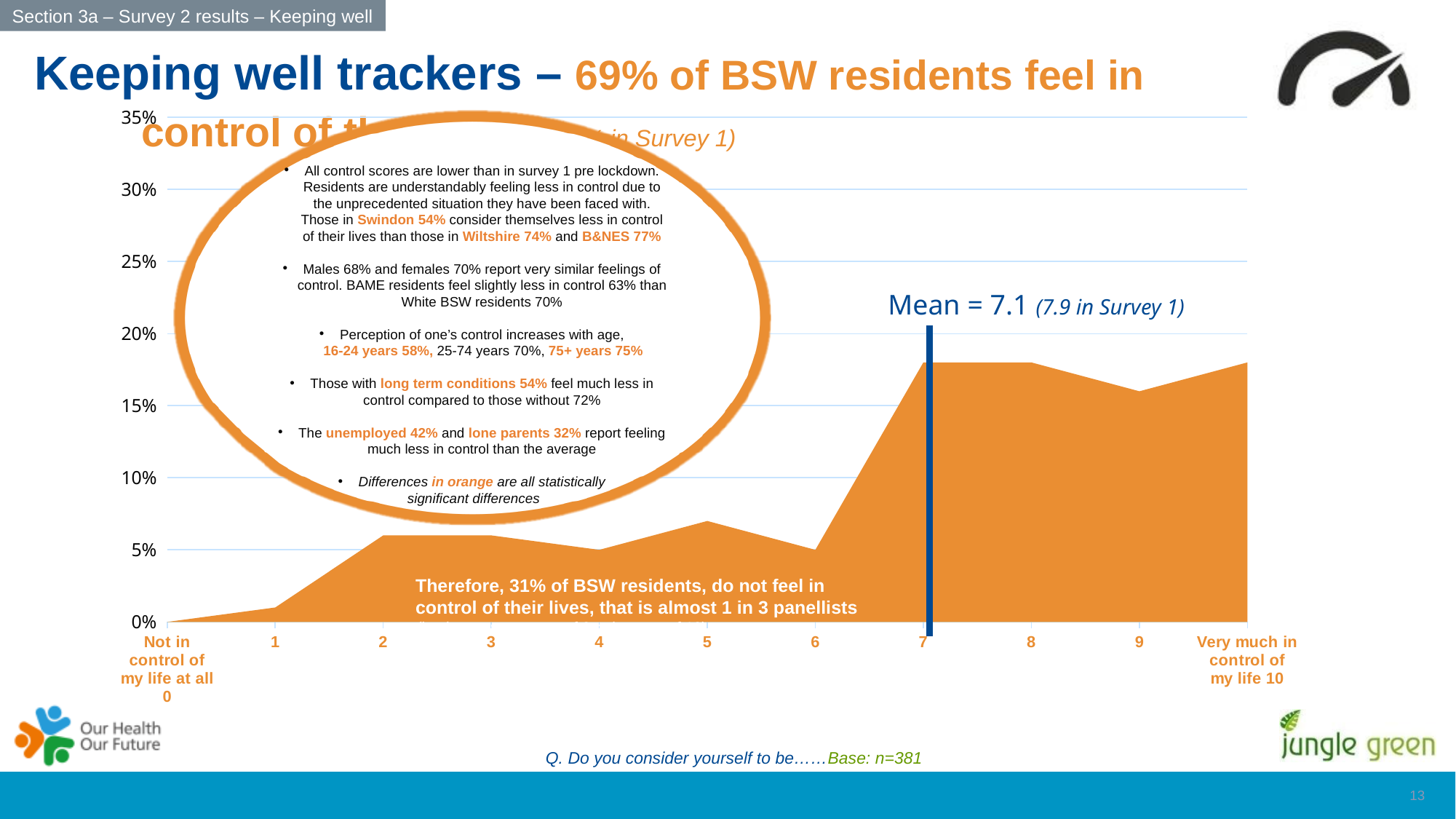
What kind of chart is shown on the slide? area chart Is the value for Very much in control of my life 10 greater or less than 15%? greater How many points on the 0-10 scale are plotted along the x axis? 11 Is the value for 9 greater or less than 10%? greater What is the base size shown for the chart? n=381 What mean score is annotated on the chart for Survey 2? 7.1 Do the values generally rise or fall from 0 to 7 along the x axis? rise Which point on the scale has the lowest value? Not in control of my life at all 0 Is the value for 6 greater or less than 10%? less Which has the larger value, 3 or 8? 8